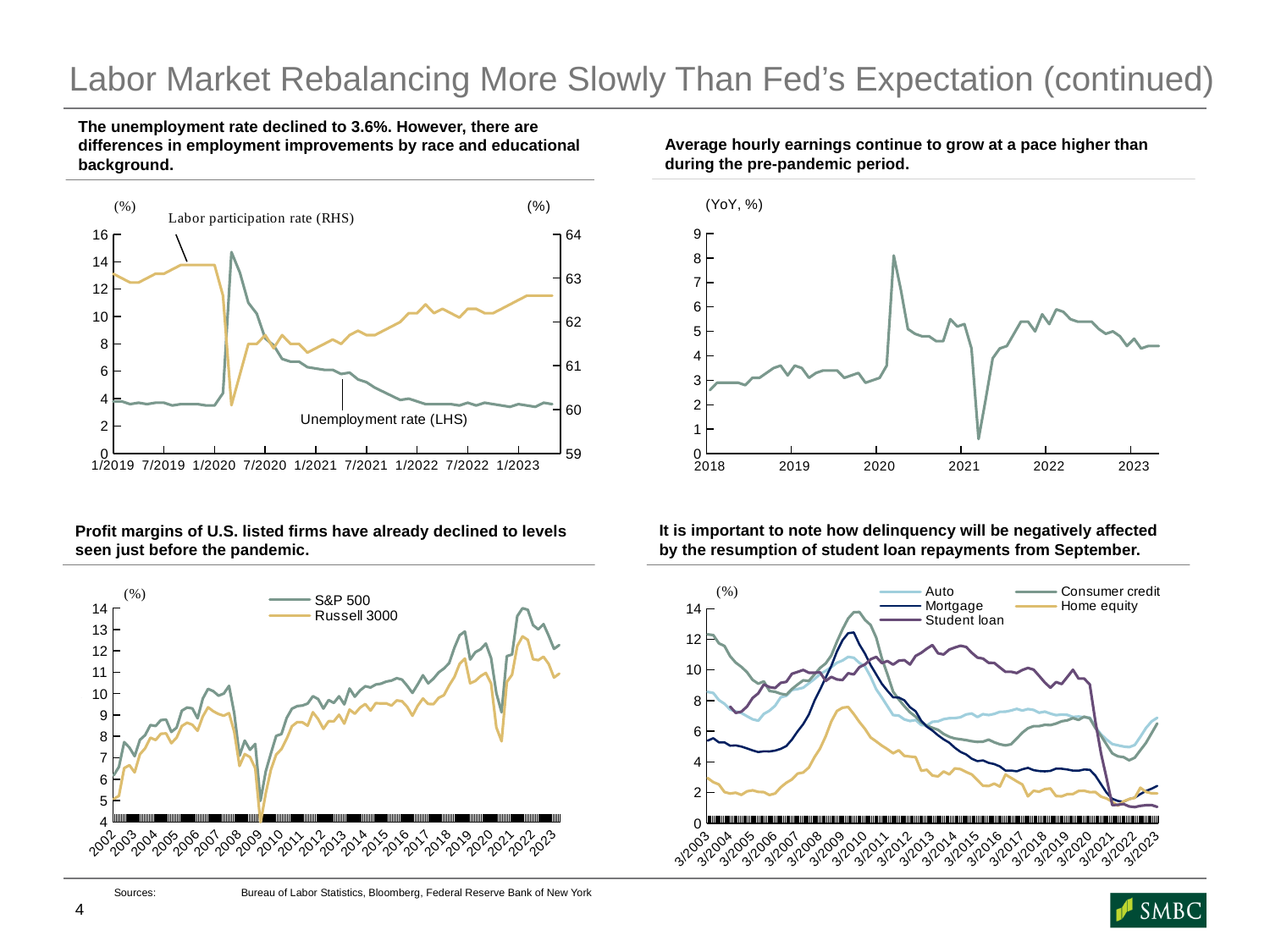
In the top-right chart of average hourly earnings (YoY, %), is the lowest point in 2021 greater or less than 1? less In the bottom-right delinquency chart, is the Student loan value in 2022 greater or less than 2? less In the top-left chart, is the peak of the unemployment rate (LHS) in 2020 greater or less than 14? greater In the top-right chart of average hourly earnings, do values rise or fall from 2022 to 2023? fall What kind of chart is the top-left chart showing the unemployment rate and labor participation rate? line chart How many series does the legend list in the bottom-right delinquency chart? 5 In the bottom-left profit margins chart, which series is higher at the 2021 peak, S&P 500 or Russell 3000? S&P 500 How many series does the legend list in the bottom-left profit margins chart? 2